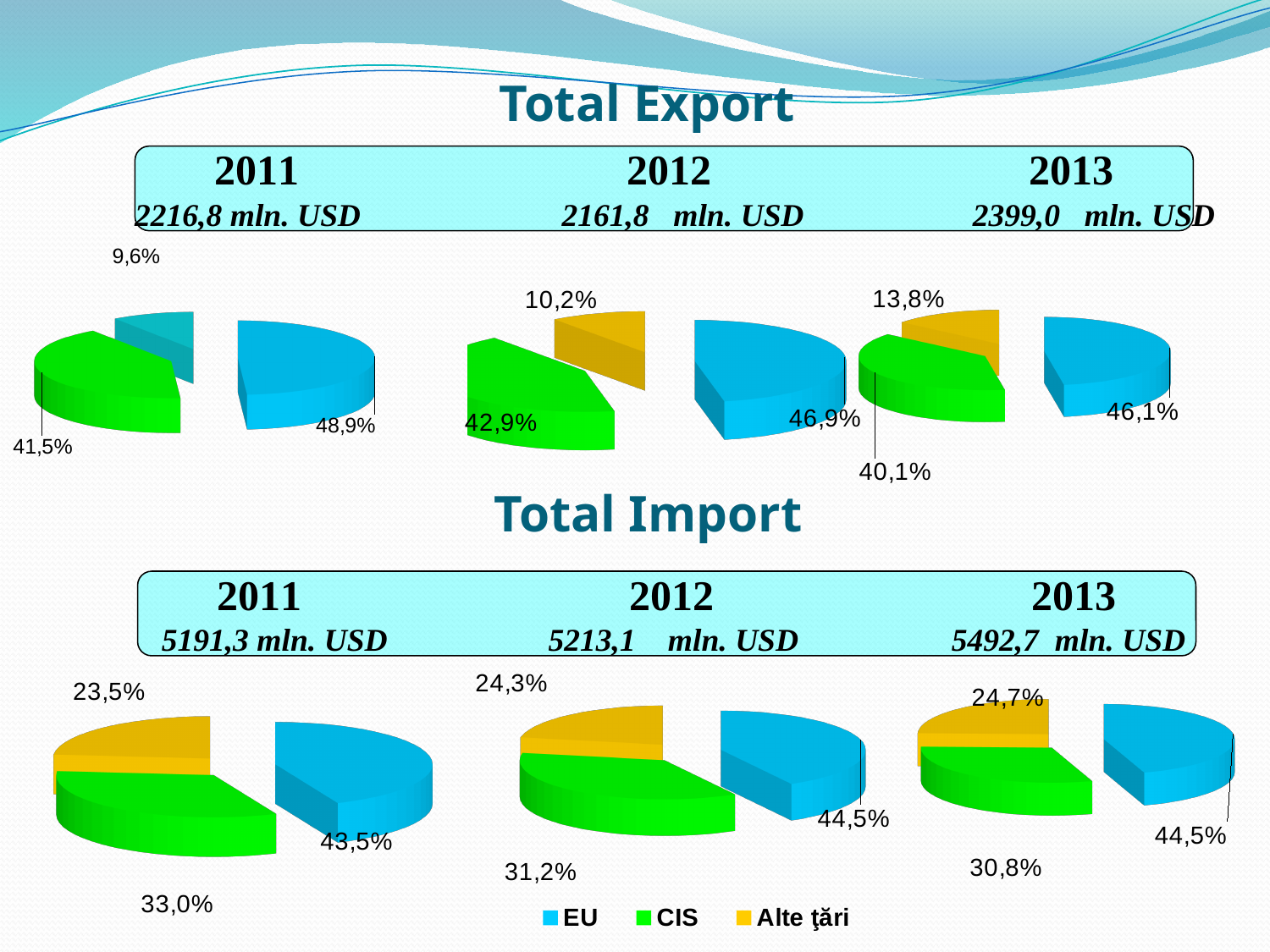
Which colour represents CIS in the legend? Green In the Total Export 2012 pie chart, what share does CIS have? 42,9% In the Total Import 2013 pie chart, what share does Alte ţări have? 24,7% What kind of chart is used for the Total Export 2012 data? Pie chart In the Total Import 2011 pie chart, what share does CIS have? 33,0% In the Total Export 2011 pie chart, what is the smallest slice's share? 9,6% In the Total Export 2013 pie chart, what is the difference between the EU share and the CIS share? 6,0% In the Total Import 2013 pie chart, which is larger, the CIS share or the Alte ţări share? CIS In the Total Import 2012 pie chart, which category has the largest share? EU In the Total Export 2013 pie chart, what share does Alte ţări have? 13,8% How many series does the legend at the bottom of the slide list? 3 In the Total Export 2011 pie chart, what share does EU have? 48,9%